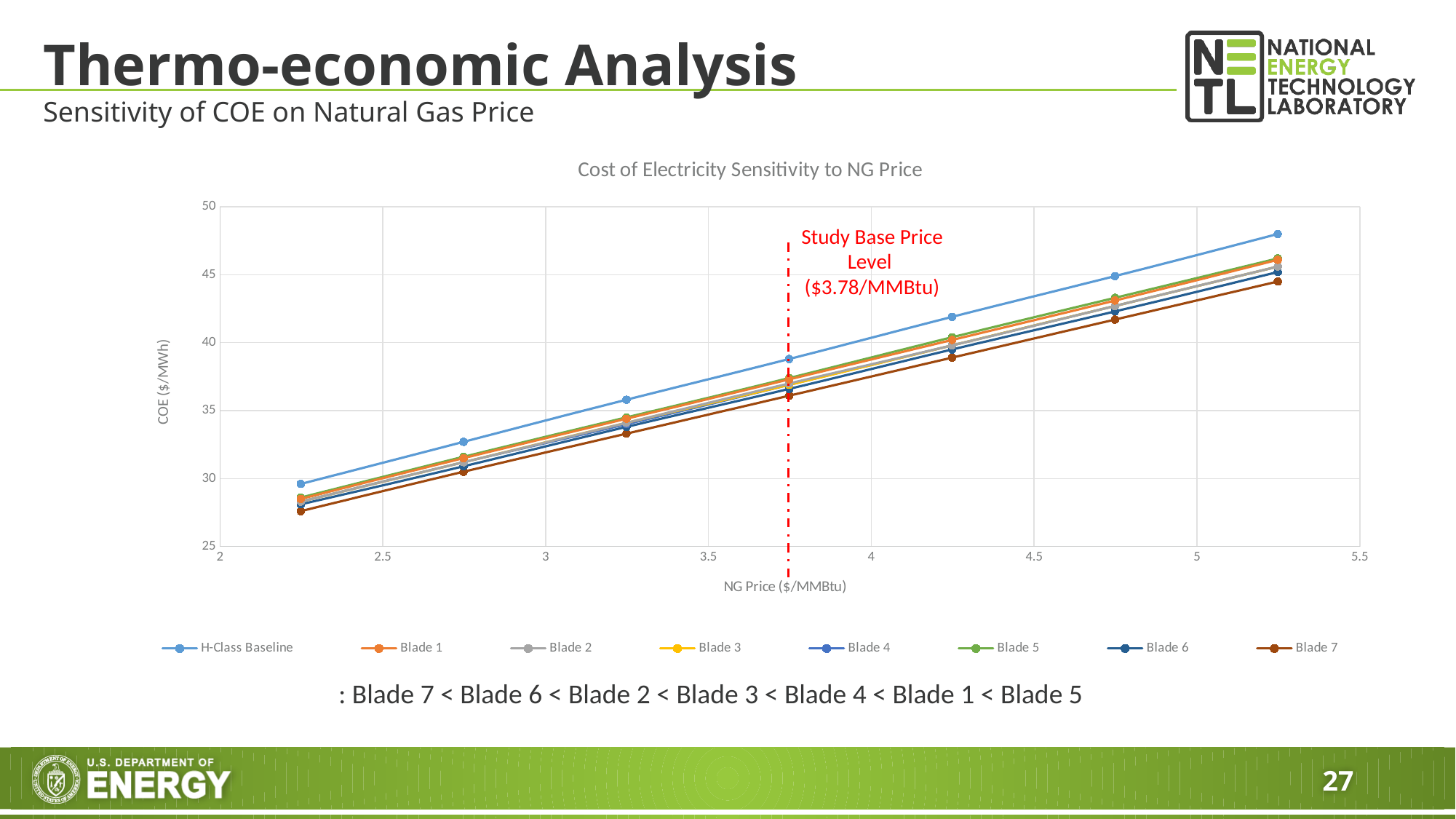
Which series has the highest COE at an NG price of 5.25 $/MMBtu? H-Class Baseline At an NG price of 5.25, which has the larger COE: H-Class Baseline or Blade 7? H-Class Baseline Which series has the lowest COE at an NG price of 5.25 $/MMBtu? Blade 7 What study base price level is marked by the red dashed vertical line? $3.78/MMBtu How many series does the legend list? 8 Do the COE values rise or fall as NG price increases along the x axis? Rise How many NG price points are plotted for each series? 7 What kind of chart is shown on the slide? Line chart What is the title of the chart? Cost of Electricity Sensitivity to NG Price Is the COE for Blade 7 at an NG price of 2.25 greater or less than 30? less Is the COE for H-Class Baseline at an NG price of 3.75 greater or less than 40? less Is the COE for H-Class Baseline at an NG price of 5.25 greater or less than 45? greater